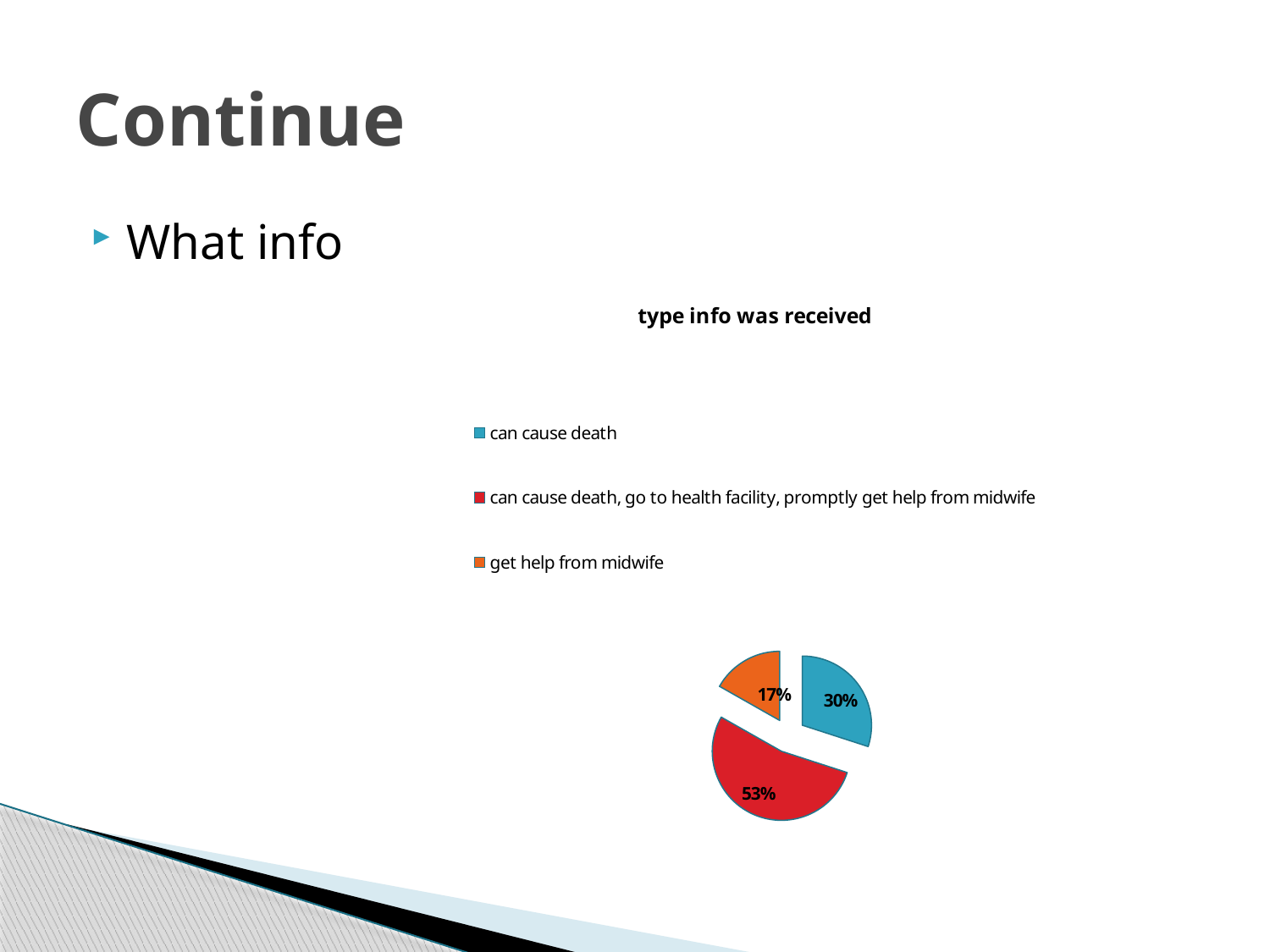
Which category has the largest slice of the pie? can cause death, go to health facility, promptly get help from midwife What share of the pie is labelled 'get help from midwife'? 17% What share of the pie is labelled 'can cause death, go to health facility, promptly get help from midwife'? 53% Which category has the smallest slice of the pie? get help from midwife How many entries does the legend list? 3 What is the difference in percentage points between the 'can cause death, go to health facility, promptly get help from midwife' slice and the 'can cause death' slice? 23% What colour is the slice for 'get help from midwife'? orange How many slices does the pie chart have? 3 Which is larger: the 'can cause death' slice or the 'get help from midwife' slice? can cause death What kind of chart is shown on the slide? pie chart What share of the pie is labelled 'can cause death'? 30% What is the title of the chart? type info was received